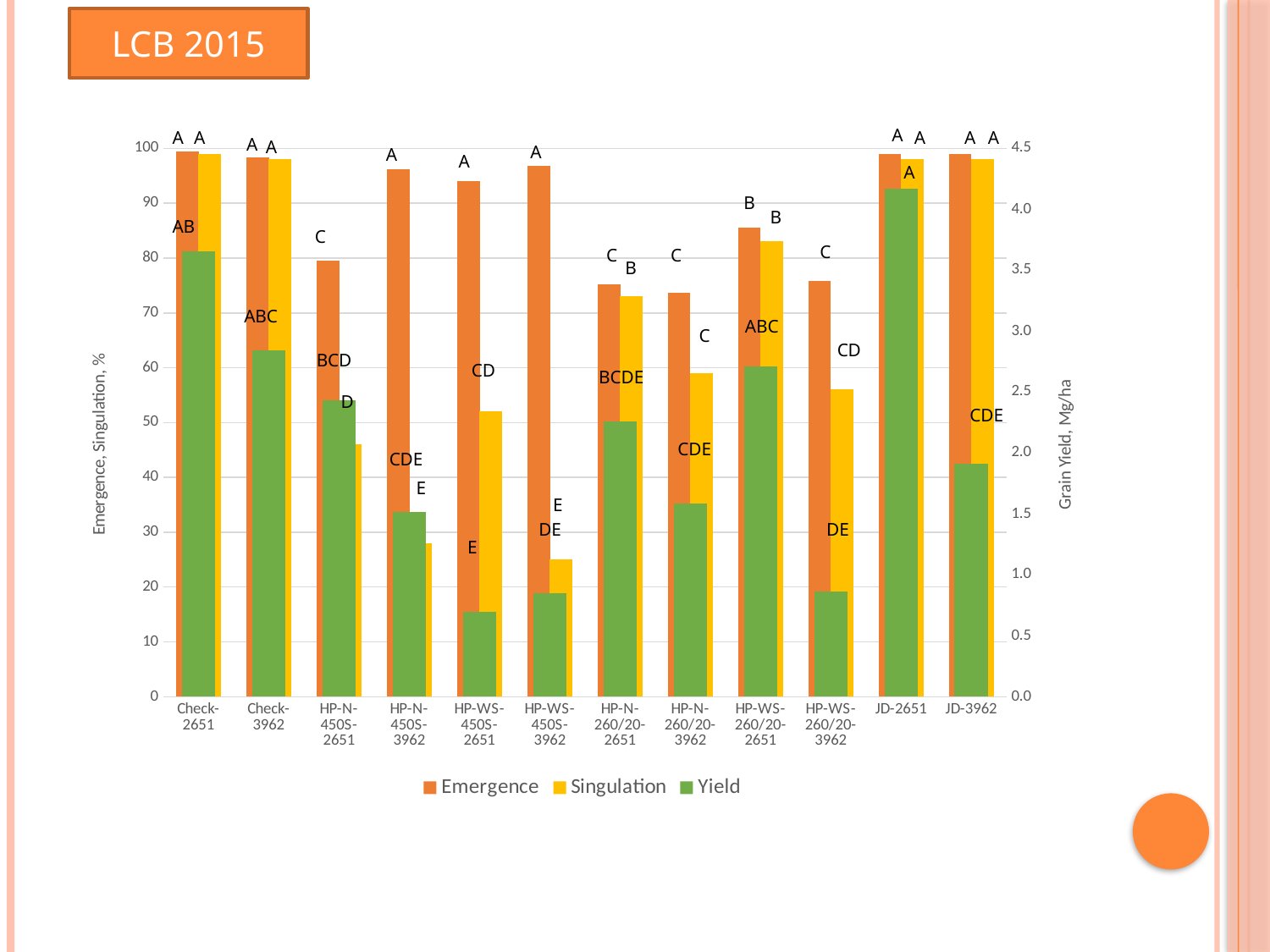
What kind of chart is shown on the slide? bar chart Among the HP- treatments, which has the highest Singulation value? HP-WS-260/20-2651 Which has the larger Singulation value, HP-N-260/20-2651 or HP-N-260/20-3962? HP-N-260/20-2651 On the right axis (Mg/ha), is the Yield for JD-2651 greater or less than 4.0? greater What is the title of the right-hand vertical axis? Grain Yield, Mg/ha Is the Emergence value for HP-N-260/20-3962 greater or less than 80? less Which has the larger Yield, JD-2651 or JD-3962? JD-2651 Is the Singulation value for HP-N-450S-3962 greater or less than 40? less How many treatment categories are shown along the x axis? 12 What are the three series named in the legend? Emergence, Singulation, Yield How many series does the legend list? 3